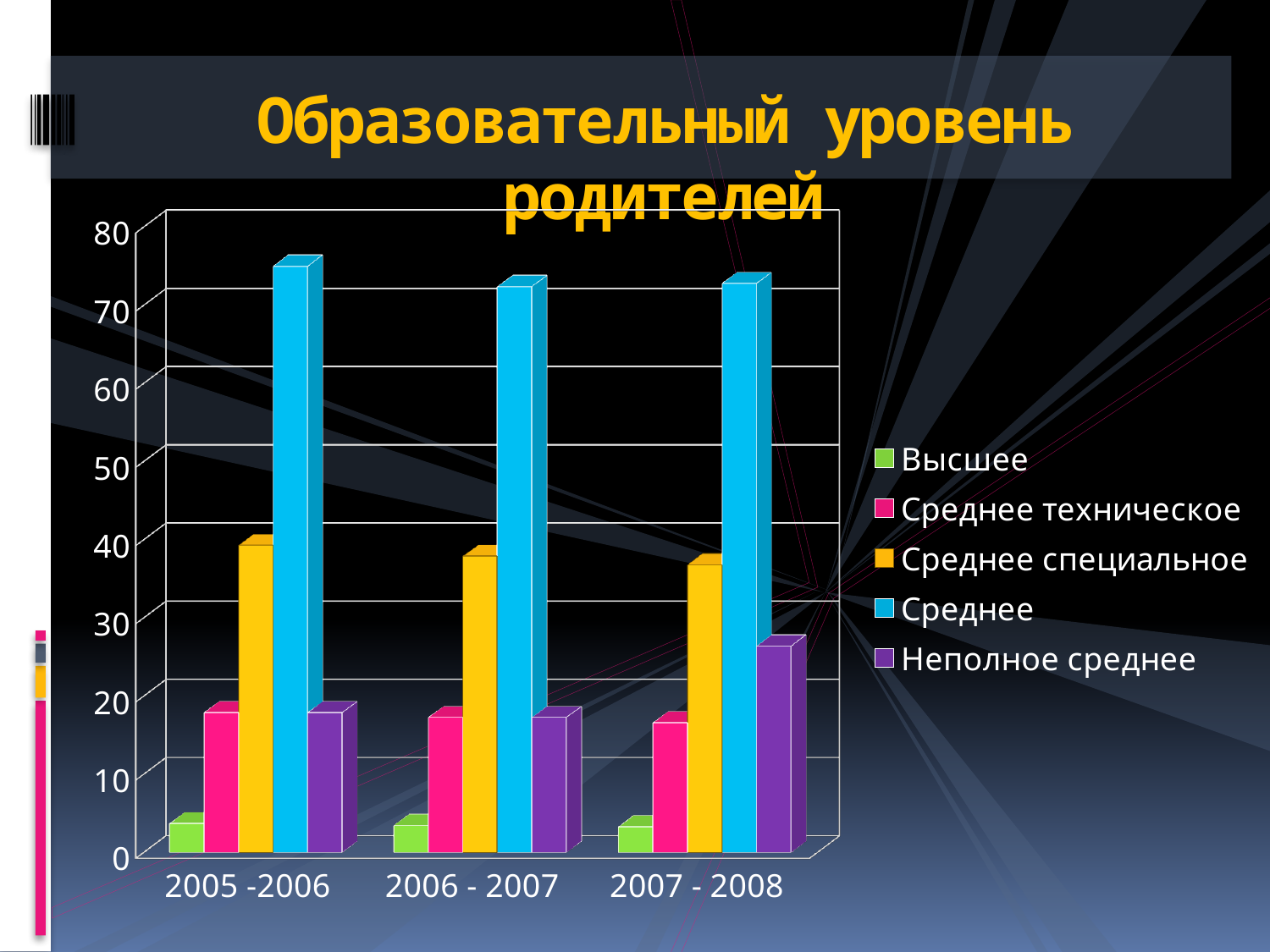
How many categories (school years) are shown on the x axis? 3 Which series has the highest value in 2005 -2006? Среднее Which is larger for Неполное среднее: 2005 -2006 or 2007 - 2008? 2007 - 2008 What kind of chart is shown on the slide? bar chart How many series does the legend list? 5 Which is larger in 2006 - 2007: Среднее специальное or Среднее техническое? Среднее специальное Which colour represents the Среднее series in the legend? blue Is the value for Высшее in 2006 - 2007 greater or less than 10? less Which series has the lowest value in 2007 - 2008? Высшее Is the value for Среднее in 2005 -2006 greater or less than 70? greater Is the value for Неполное среднее in 2007 - 2008 greater or less than 20? greater What is the title of the chart? Образовательный уровень родителей